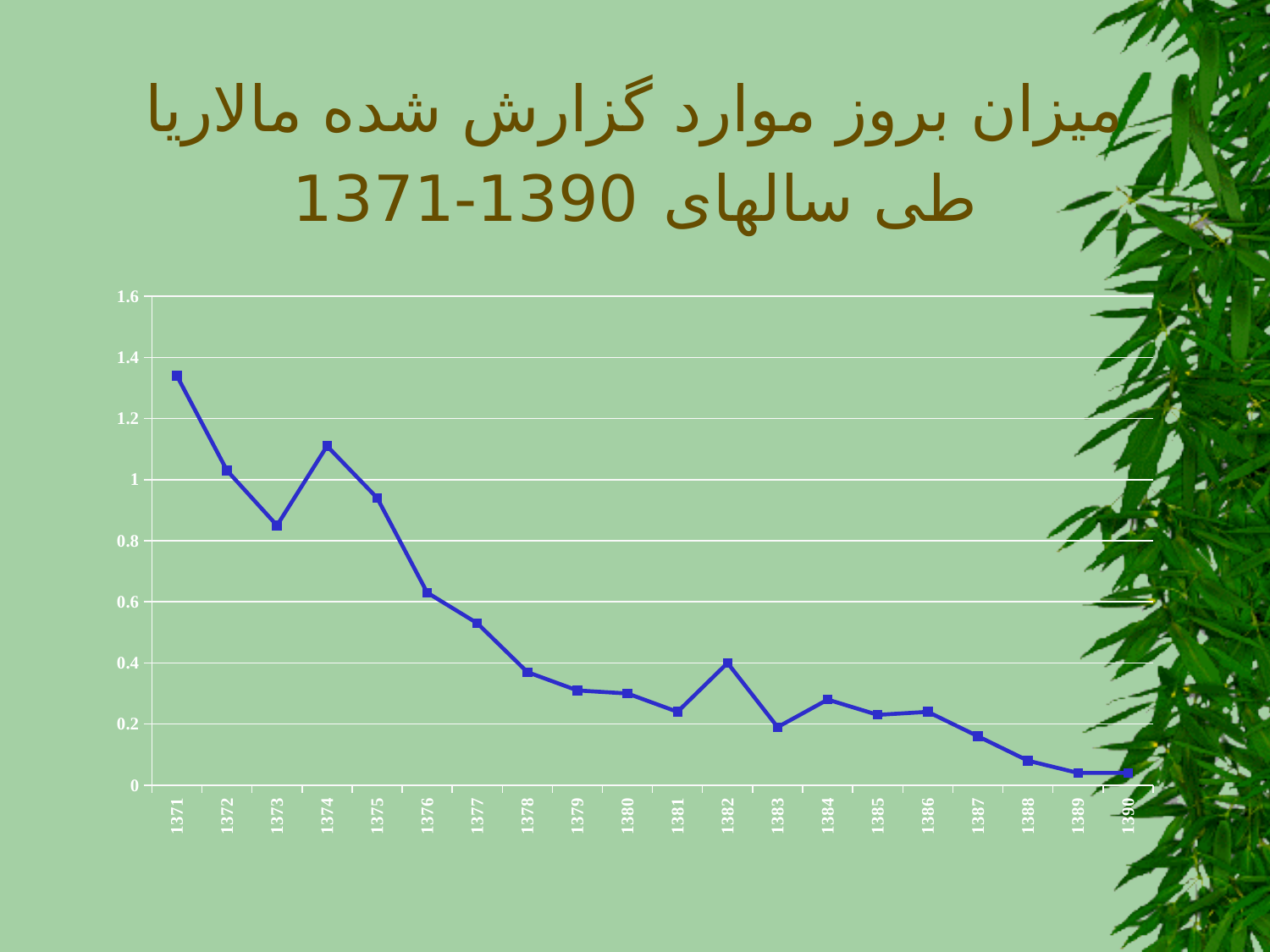
Which year has the highest value on the chart? 1371 Is the value for 1374 greater or less than 1? greater Which year has the larger value, 1381 or 1382? 1382 What kind of chart is shown on the slide? line chart Is the value for 1371 greater or less than 1.2? greater What is the highest value shown on the y axis? 1.6 How many years (data points) are plotted on the x axis? 20 Which year has the larger value, 1373 or 1374? 1374 Is the value for 1388 greater or less than 0.2? less Overall, do the values rise or fall from 1371 to 1390? fall